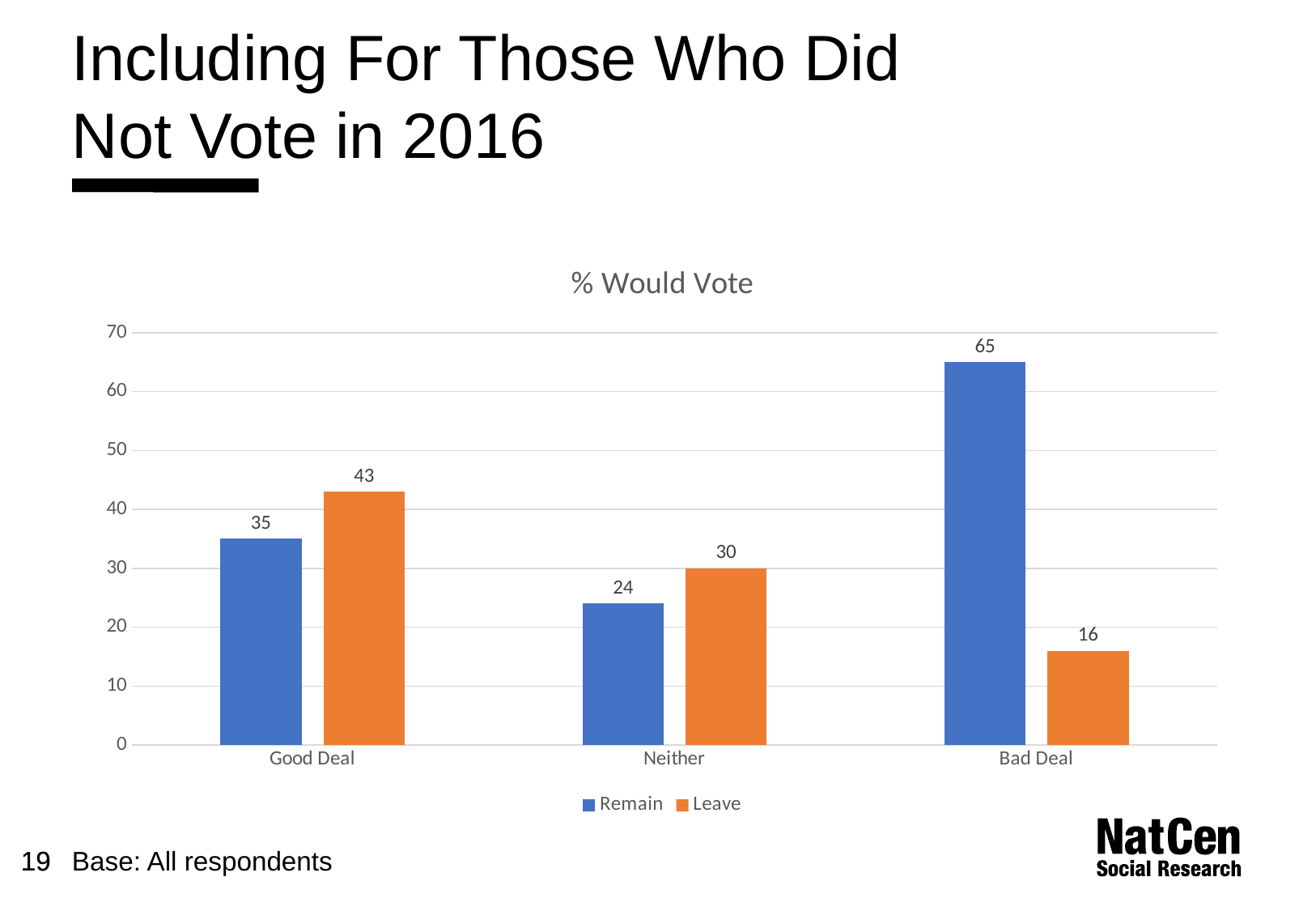
Which category has the highest Remain value? Bad Deal In the Good Deal category, which is larger, Remain or Leave? Leave Is the Remain value for Neither greater or less than 30? less What is the difference between the Remain and Leave values in the Bad Deal category? 49 What kind of chart is shown on the slide? Bar chart What is the value for Leave in the Neither category? 30 What is the value for Leave in the Bad Deal category? 16 Which category has the lowest Leave value? Bad Deal What is the value for Remain in the Good Deal category? 35 How many series does the legend list? 2 How many categories are shown on the x axis? 3 What is the title of the chart? % Would Vote